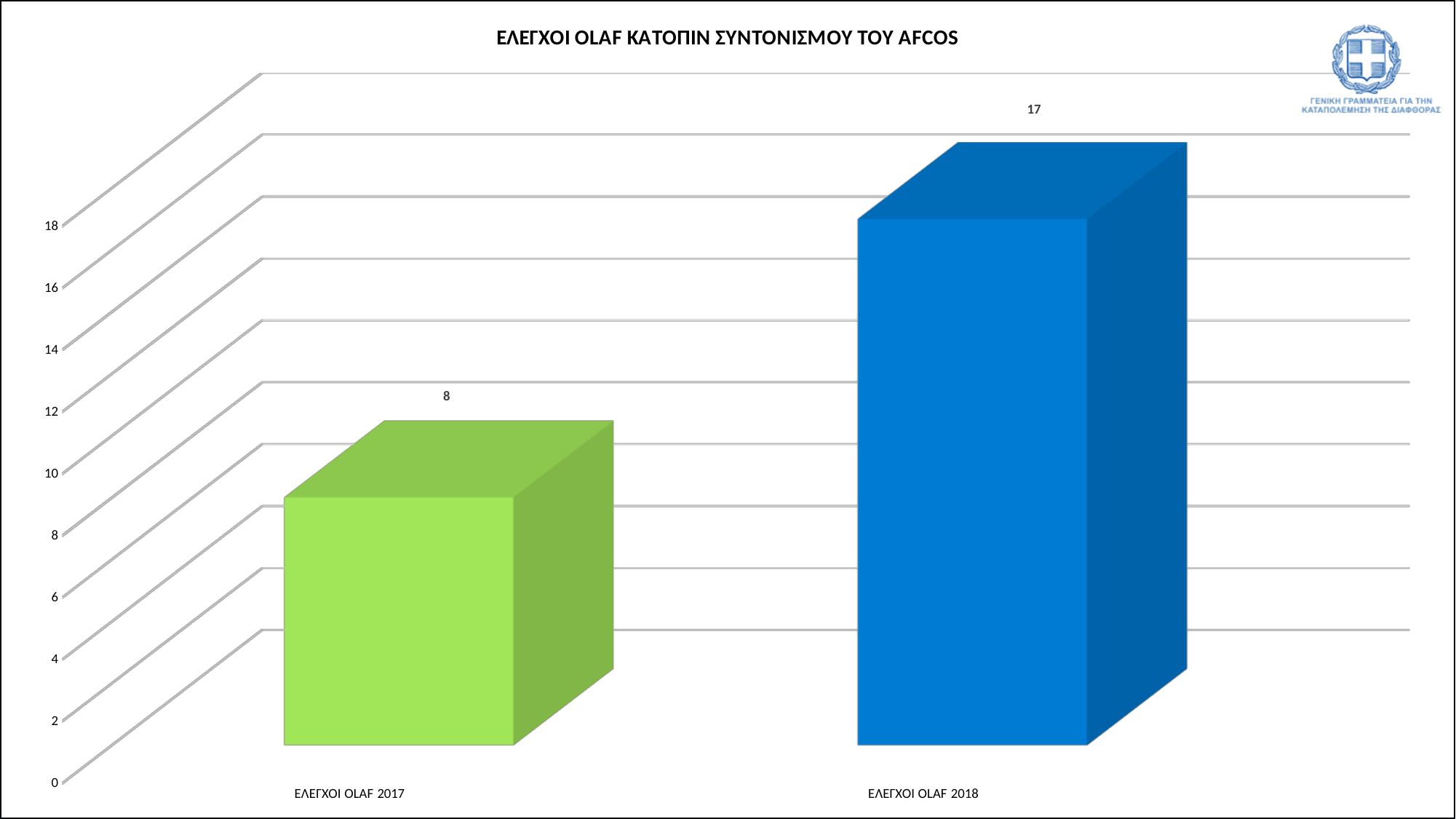
Which is larger, the value for ΕΛΕΓΧΟΙ OLAF 2017 or ΕΛΕΓΧΟΙ OLAF 2018? ΕΛΕΓΧΟΙ OLAF 2018 What kind of chart is shown on the slide? bar chart Is the value for ΕΛΕΓΧΟΙ OLAF 2017 greater or less than 12? less What is the value for ΕΛΕΓΧΟΙ OLAF 2017? 8 What is the difference between the values for ΕΛΕΓΧΟΙ OLAF 2018 and ΕΛΕΓΧΟΙ OLAF 2017? 9 Which category has the lowest value? ΕΛΕΓΧΟΙ OLAF 2017 Do the values rise or fall from ΕΛΕΓΧΟΙ OLAF 2017 to ΕΛΕΓΧΟΙ OLAF 2018? rise What is the value for ΕΛΕΓΧΟΙ OLAF 2018? 17 Which category has the highest value? ΕΛΕΓΧΟΙ OLAF 2018 What is the title of the chart? ΕΛΕΓΧΟΙ OLAF ΚΑΤΟΠΙΝ ΣΥΝΤΟΝΙΣΜΟΥ ΤΟΥ AFCOS How many categories are shown in the chart? 2 Is the value for ΕΛΕΓΧΟΙ OLAF 2018 greater or less than 10? greater